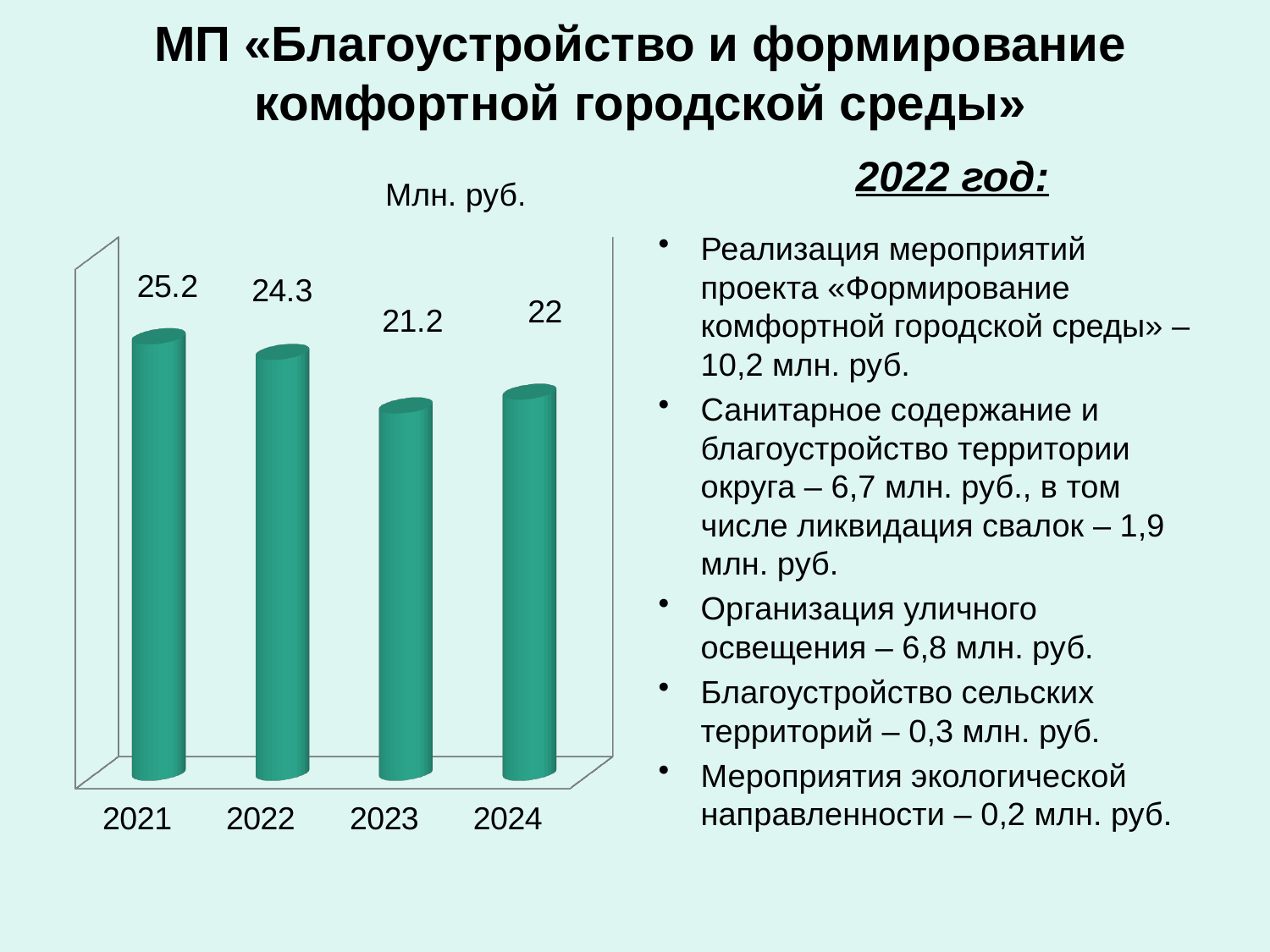
What is the title of the chart? Млн. руб. Which year has the highest value? 2021 How many years are shown on the chart? 4 What kind of chart is shown on the slide? bar chart Which year has the lowest value? 2023 What is the difference between the values for 2022 and 2024? 2.3 What is the difference between the values for 2021 and 2023? 4 What is the value for 2021? 25.2 What is the value for 2024? 22 What is the value for 2023? 21.2 Which is larger, the value for 2023 or the value for 2024? 2024 What is the value for 2022? 24.3